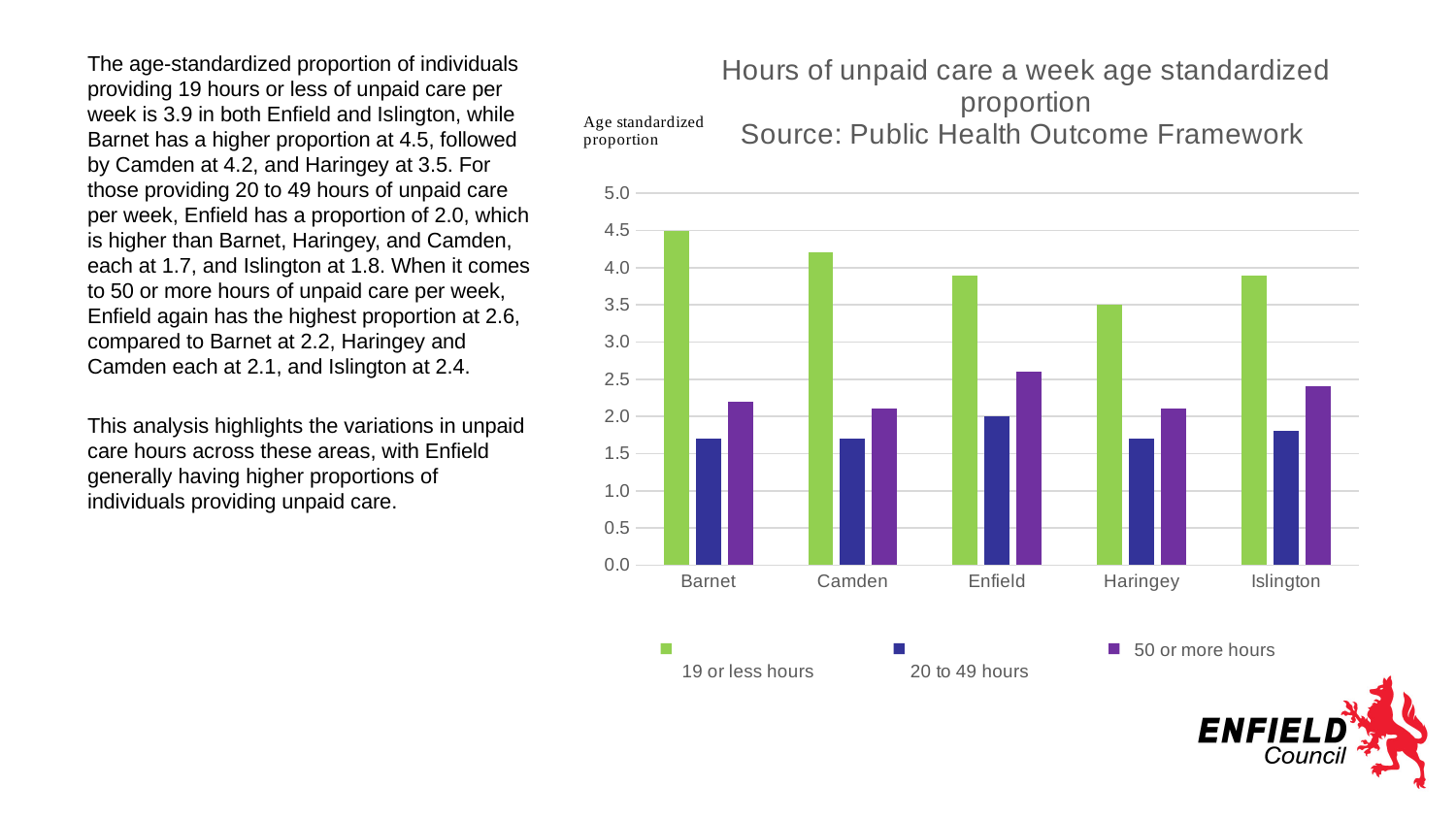
What is the age standardized proportion for 20 to 49 hours in Enfield? 2.0 How many areas are shown on the x axis? 5 What is the age standardized proportion for 19 or less hours in Barnet? 4.5 What is the difference between the 19 or less hours proportion in Barnet and in Haringey? 1.0 Which is larger for 19 or less hours: Camden or Enfield? Camden Which area has the lowest proportion for 19 or less hours? Haringey Is the value for 50 or more hours in Islington greater or less than 2.0? greater What kind of chart is shown on the slide? bar chart What is the age standardized proportion for 19 or less hours in Haringey? 3.5 Which area has the highest proportion for 50 or more hours? Enfield How many series does the legend list? 3 Which area has the highest proportion for 19 or less hours? Barnet